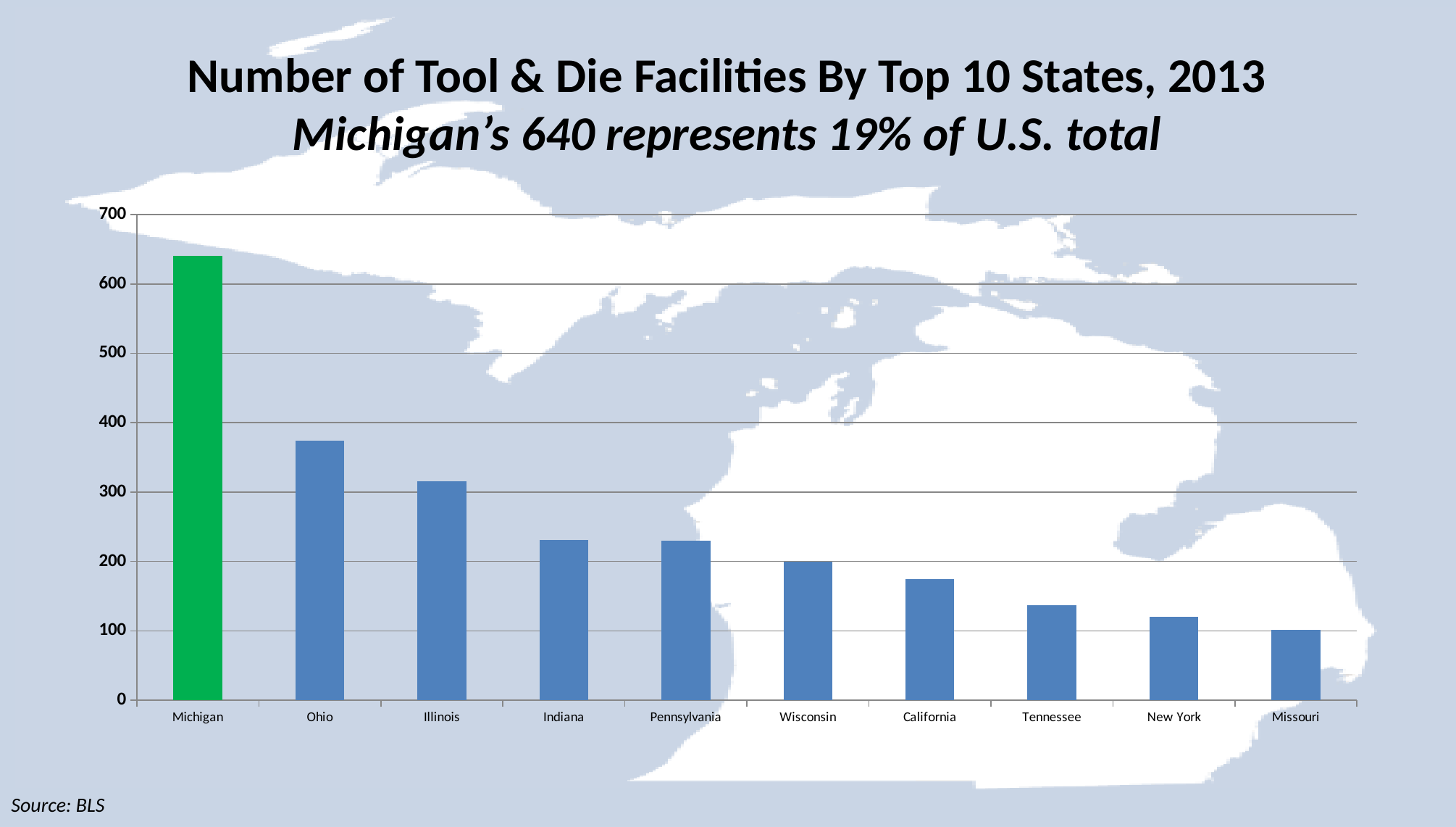
What colour is the bar for Michigan? green Do the values rise or fall moving from left to right across the states? fall Is the value for Ohio greater or less than 300? greater Which has more tool & die facilities, Ohio or Illinois? Ohio Is the value for California greater or less than 200? less Is the value for Ohio greater or less than 400? less How many states are shown on the chart? 10 Which state has the highest number of tool & die facilities? Michigan What type of chart is shown on the slide? bar chart Which state has the lowest number of tool & die facilities among those shown? Missouri How many tool & die facilities does Michigan have according to the slide? 640